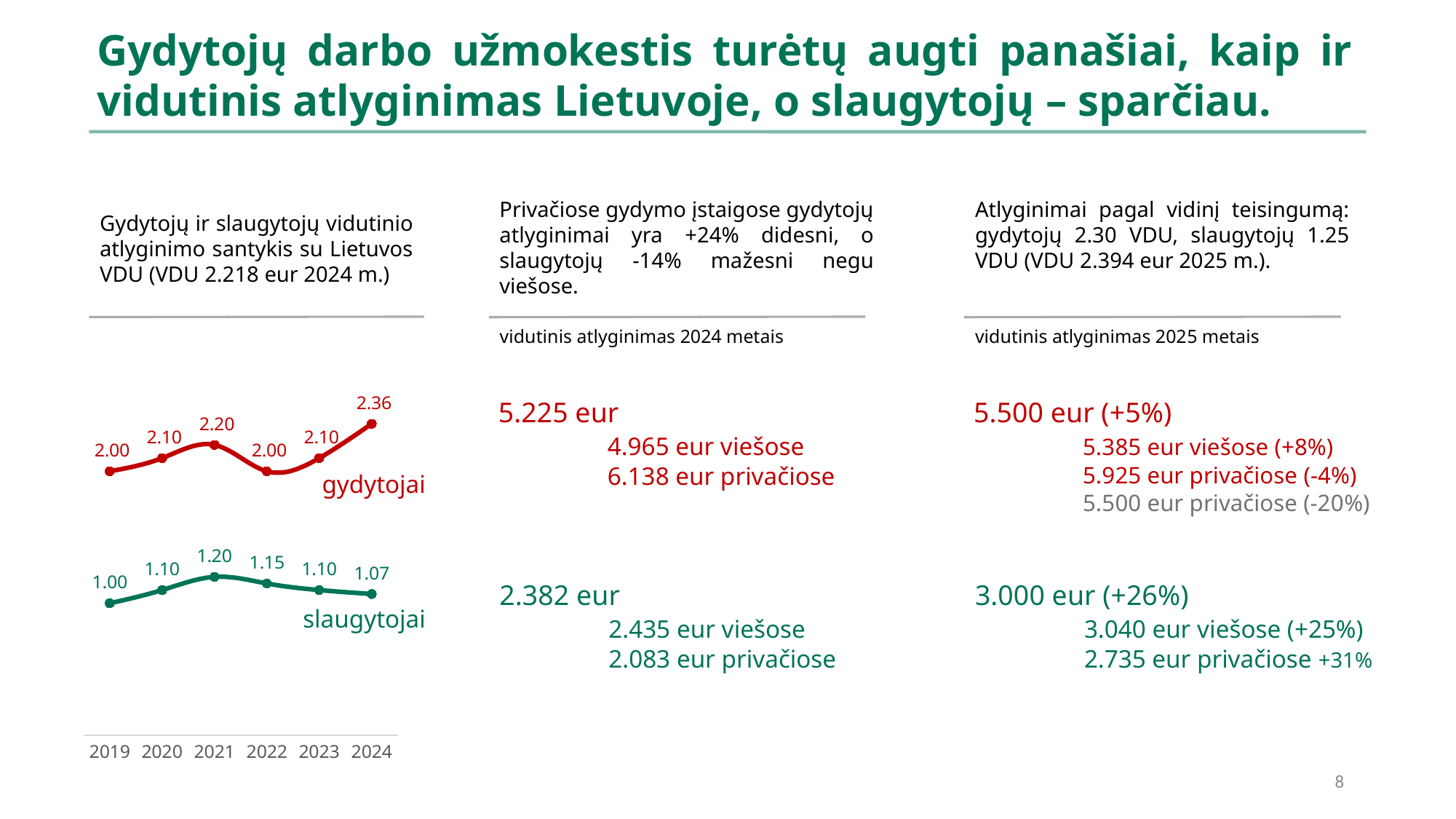
What is the difference between the gydytojai and slaugytojai values in 2024? 1.29 What is the value for slaugytojai in 2019? 1.00 What is the value for slaugytojai in 2021? 1.20 Which is larger: the slaugytojai value in 2021 or in 2024? 2021 How many series are plotted in the chart? 2 How many years are shown on the x axis of the chart? 6 In which year is the gydytojai value highest? 2024 What is the value for gydytojai in 2022? 2.00 In which year is the slaugytojai value lowest? 2019 Does the slaugytojai line rise or fall from 2021 to 2024? fall What is the value for gydytojai in 2024? 2.36 What type of chart is shown on the left of the slide? line chart